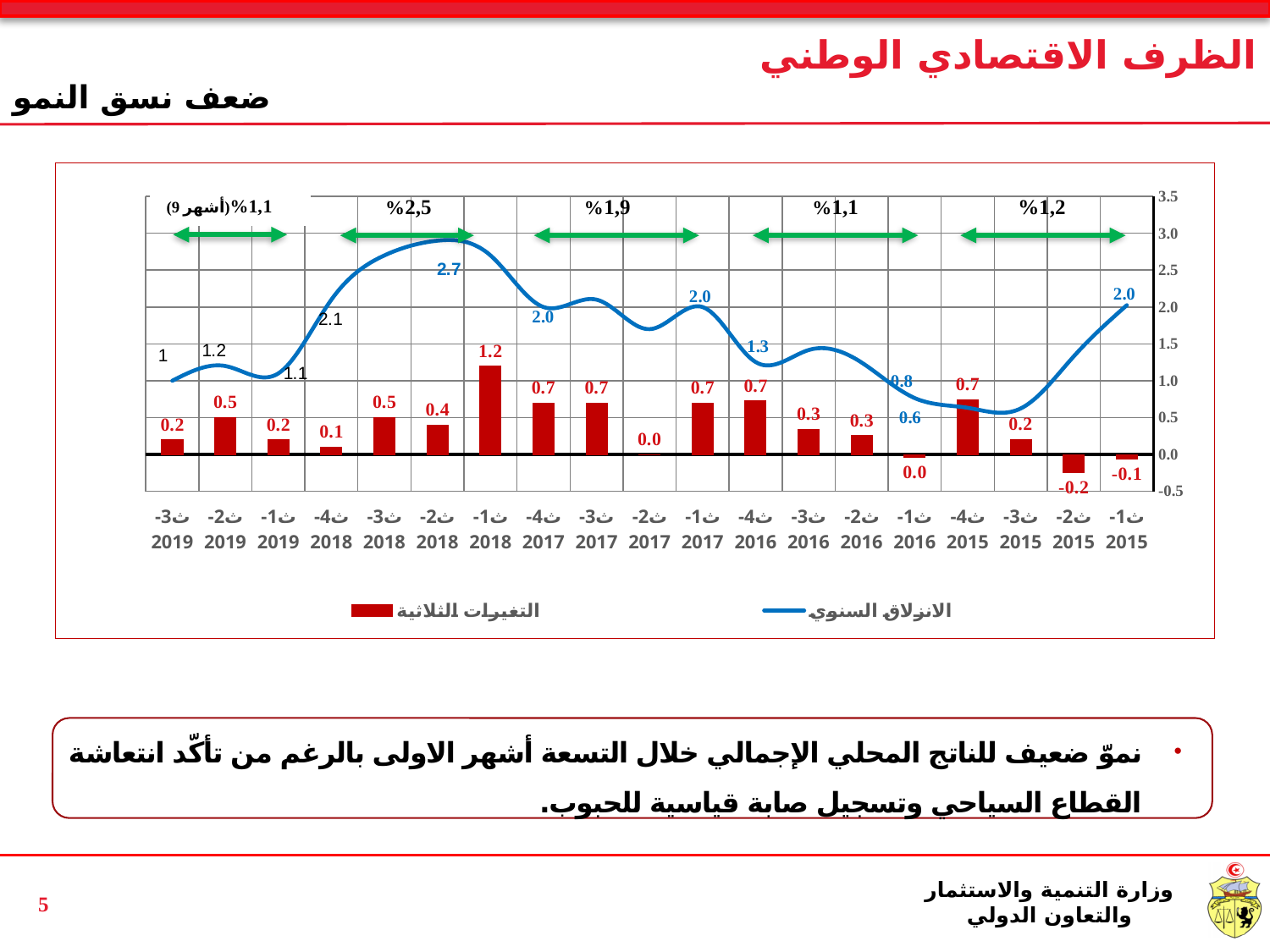
What is the difference between the red bar values for ث1-2018 and ث2-2018? 0.8 What is the value of the red bar for ث2-2015? -0.2 What value does the blue line show for ث4-2016? 1.3 Which quarter has the highest red bar value? ث1-2018 Which is larger, the red bar for ث4-2015 or the red bar for ث3-2015? ث4-2015 How many quarters are shown on the x axis? 19 What annual growth percentage is shown above the chart for 2018? %2,5 What kind of chart is shown on the slide? Combined bar and line chart Which quarter has the lowest red bar value? ث2-2015 What is the value of the red bar (التغيرات الثلاثية) for ث1-2018? 1.2 How many series does the legend list? 2